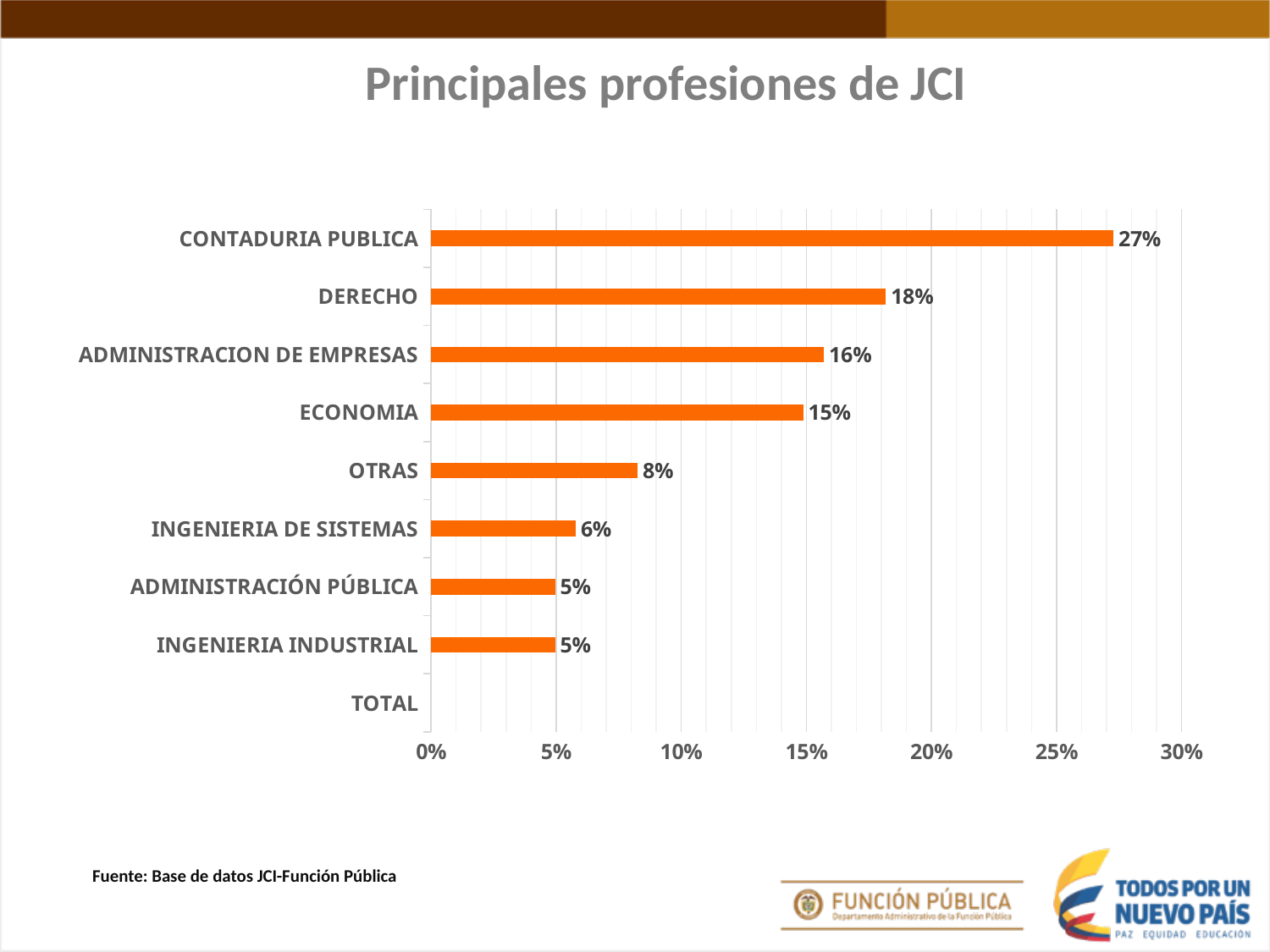
Which is larger, the value for ECONOMIA or the value for OTRAS? ECONOMIA What is the difference between the values for CONTADURIA PUBLICA and DERECHO? 9% How many professions have a bar plotted on the chart? 8 What kind of chart is shown on the slide? bar chart What is the difference between the values for ADMINISTRACION DE EMPRESAS and OTRAS? 8% What is the value for INGENIERIA DE SISTEMAS? 6% Which profession has the highest value? CONTADURIA PUBLICA What is the value for CONTADURIA PUBLICA? 27% What is the value for DERECHO? 18% What is the value for ECONOMIA? 15% Is the value for DERECHO greater or less than 20%? less What is the title of the chart? Principales profesiones de JCI